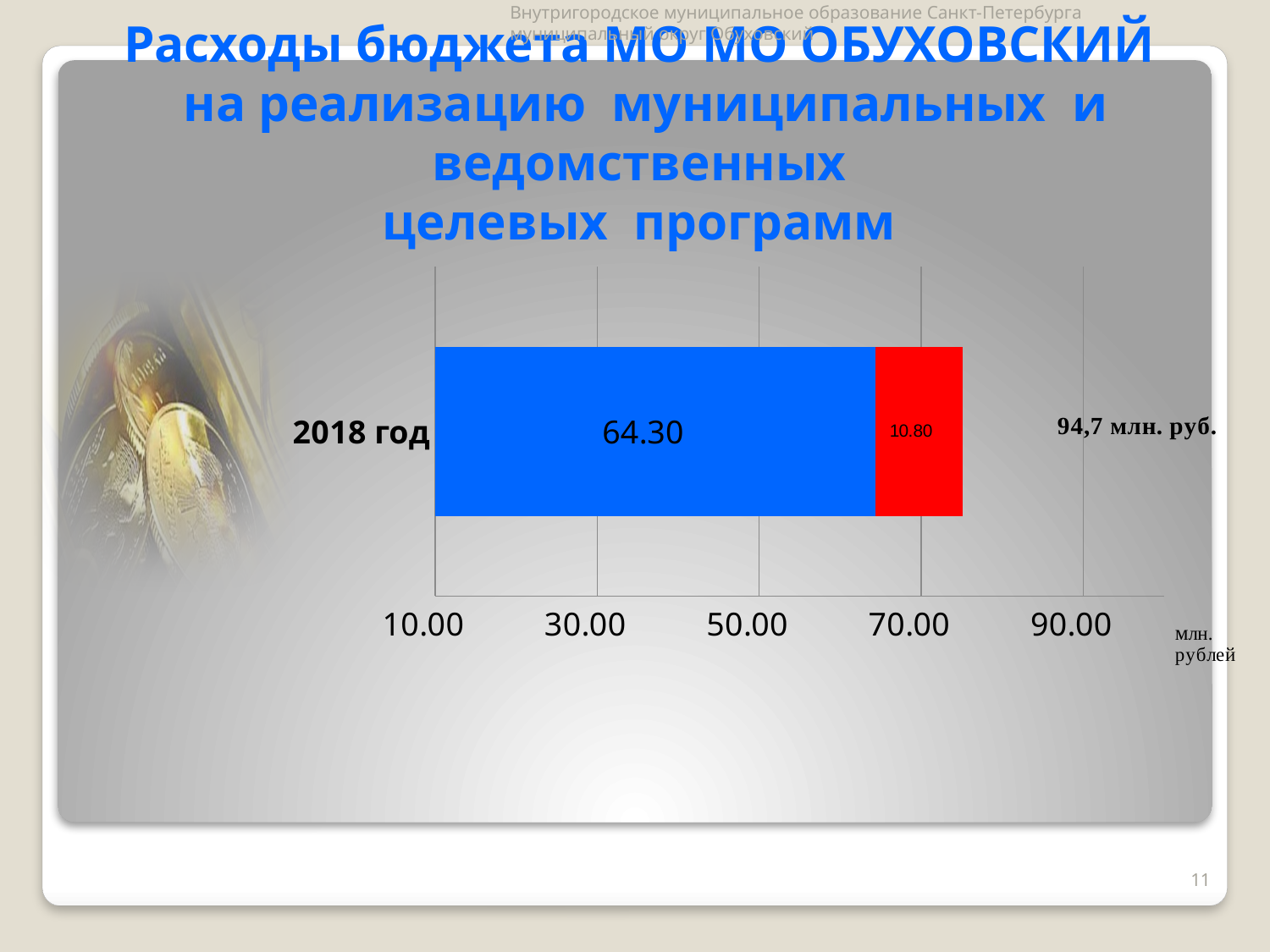
What is the difference between the blue segment value (64.30) and the red segment value (10.80) for 2018 год? 53.50 Which year is shown as the category label on the chart? 2018 год What is the value of the blue segment of the bar for 2018 год? 64.30 What is the largest segment value shown on the chart? 64.30 Which segment of the 2018 год bar is larger, the blue one or the red one? the blue one What kind of chart is shown on the slide? bar chart Is the value of the blue segment for 2018 год greater or less than 50.00? greater How many categories (years) are plotted on the chart? 1 What is the value of the red segment of the bar for 2018 год? 10.80 What text label is printed to the right of the 2018 год bar? 94,7 млн. руб. What unit is written next to the horizontal axis of the chart? млн. рублей Is the value of the red segment for 2018 год greater or less than 30.00? less